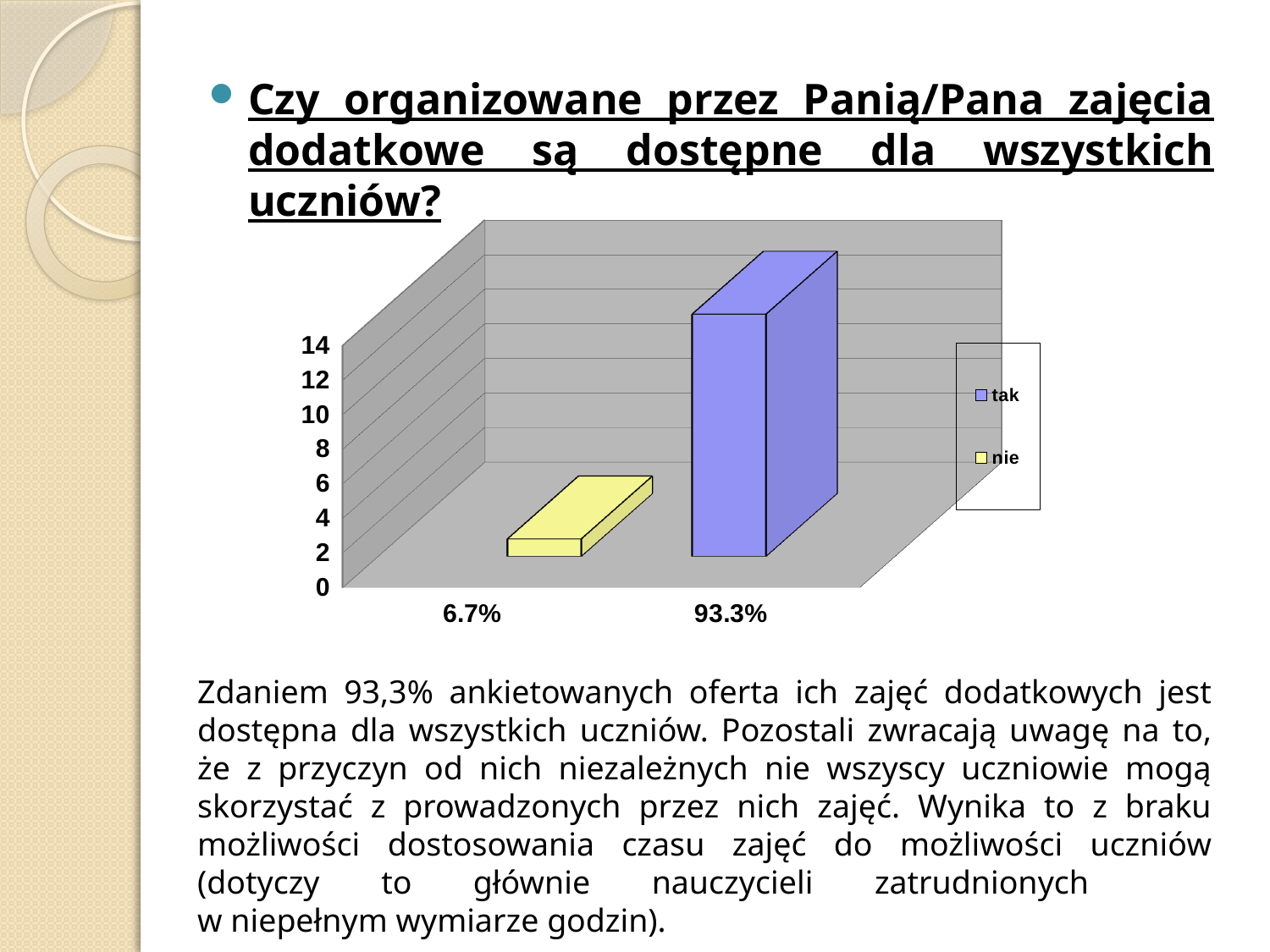
Which series has the tallest bar in the chart? tak What are the two entries listed in the chart legend? tak, nie What percentage label appears on the x axis under the yellow 'nie' bar? 6.7% What is the highest tick value shown on the vertical axis of the chart? 14 Which bar is taller, 'tak' or 'nie'? tak What kind of chart is shown on the slide? bar chart Is the value for 'tak' greater or less than 10? greater How many bars are plotted in the chart? 2 Which series has the shortest bar in the chart? nie Is the value for 'nie' greater or less than 4? less How many series does the chart legend list? 2 What percentage label appears on the x axis under the blue 'tak' bar? 93.3%